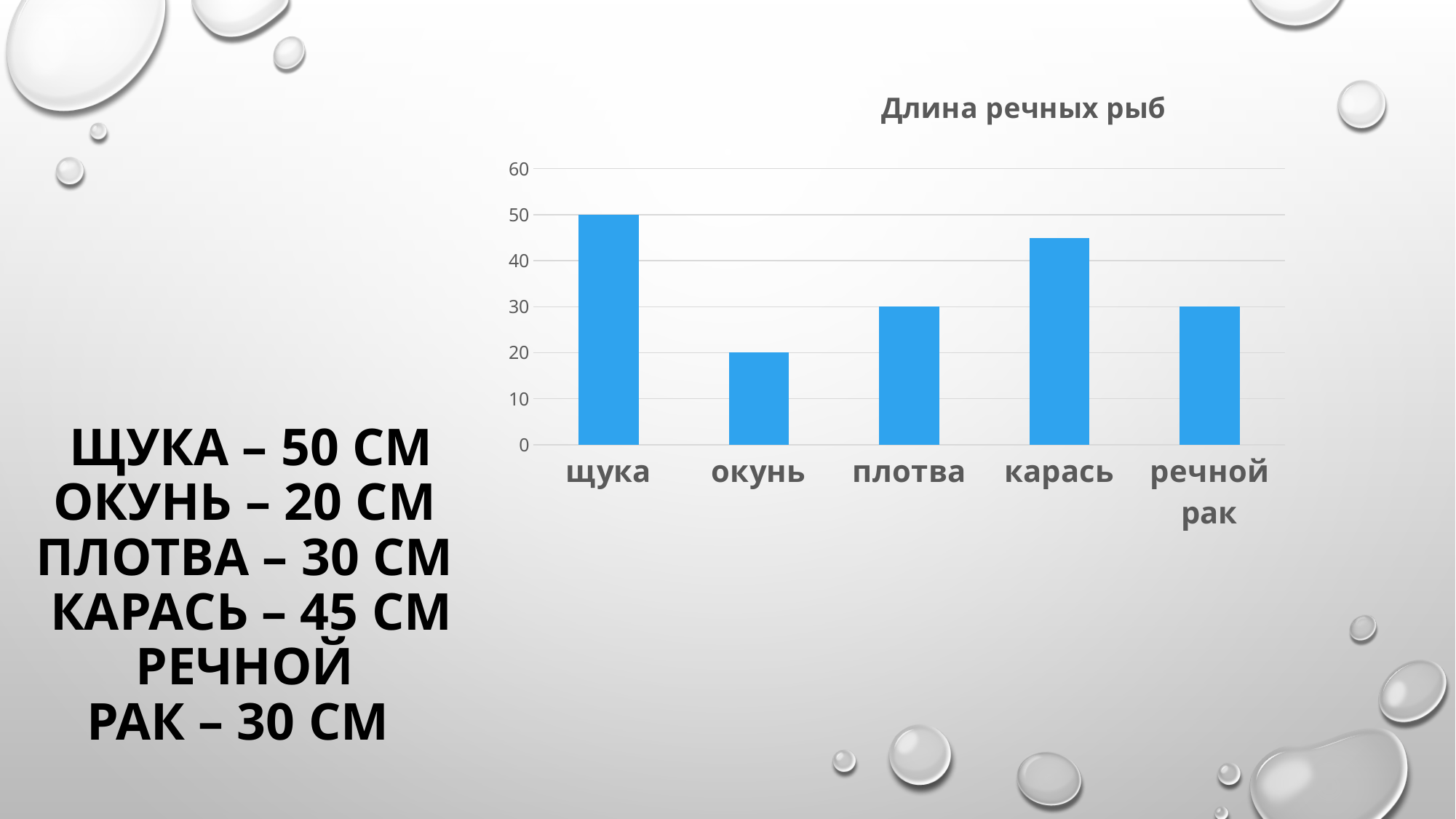
What is the value for карась in the chart? 45 What is the value for окунь in the chart? 20 Which category has the lowest value in the chart? окунь Which is larger, the value for карась or the value for плотва? карась What is the difference between the values for щука and окунь? 30 What is the title of the chart? Длина речных рыб Which category has the highest value in the chart? щука What kind of chart is shown on the slide? bar chart What is the value for щука in the chart? 50 What is the value for речной рак in the chart? 30 How many categories are shown on the x axis of the chart? 5 Is the value for карась greater or less than 40? greater